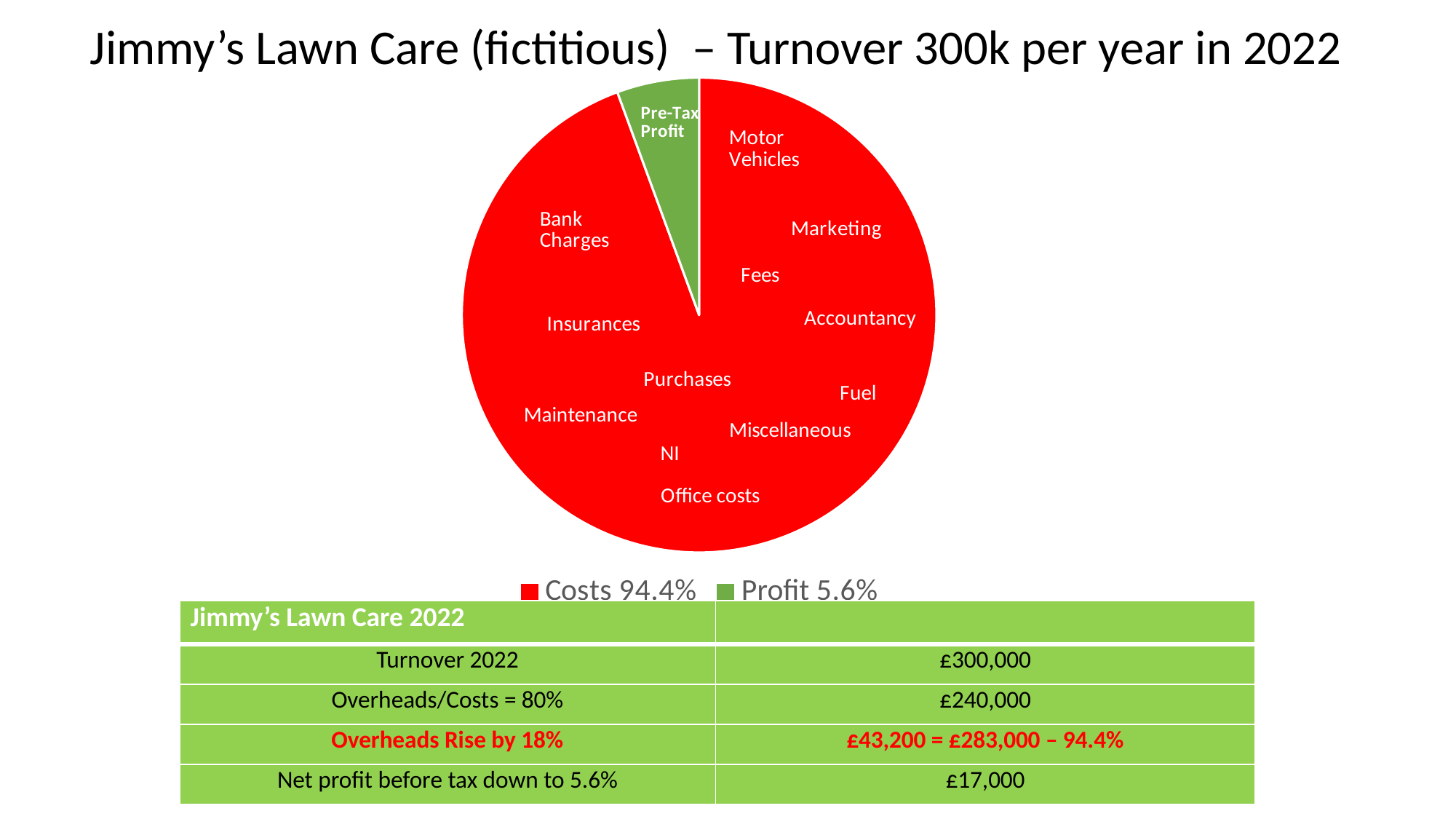
What share of the pie does Profit take? 5.6% How many entries does the legend of the pie chart list? 2 What is the difference in percentage points between the Costs share and the Profit share? 88.8% What colour is the Profit slice in the pie chart? green Which slice of the pie chart is the smallest? Profit How many slices does the pie chart have? 2 What share of the pie does Costs take? 94.4% Which is larger in the pie chart, Costs or Profit? Costs What label is printed inside the green slice of the pie chart? Pre-Tax Profit What kind of chart is shown on the slide? pie chart Which slice of the pie chart is the largest? Costs